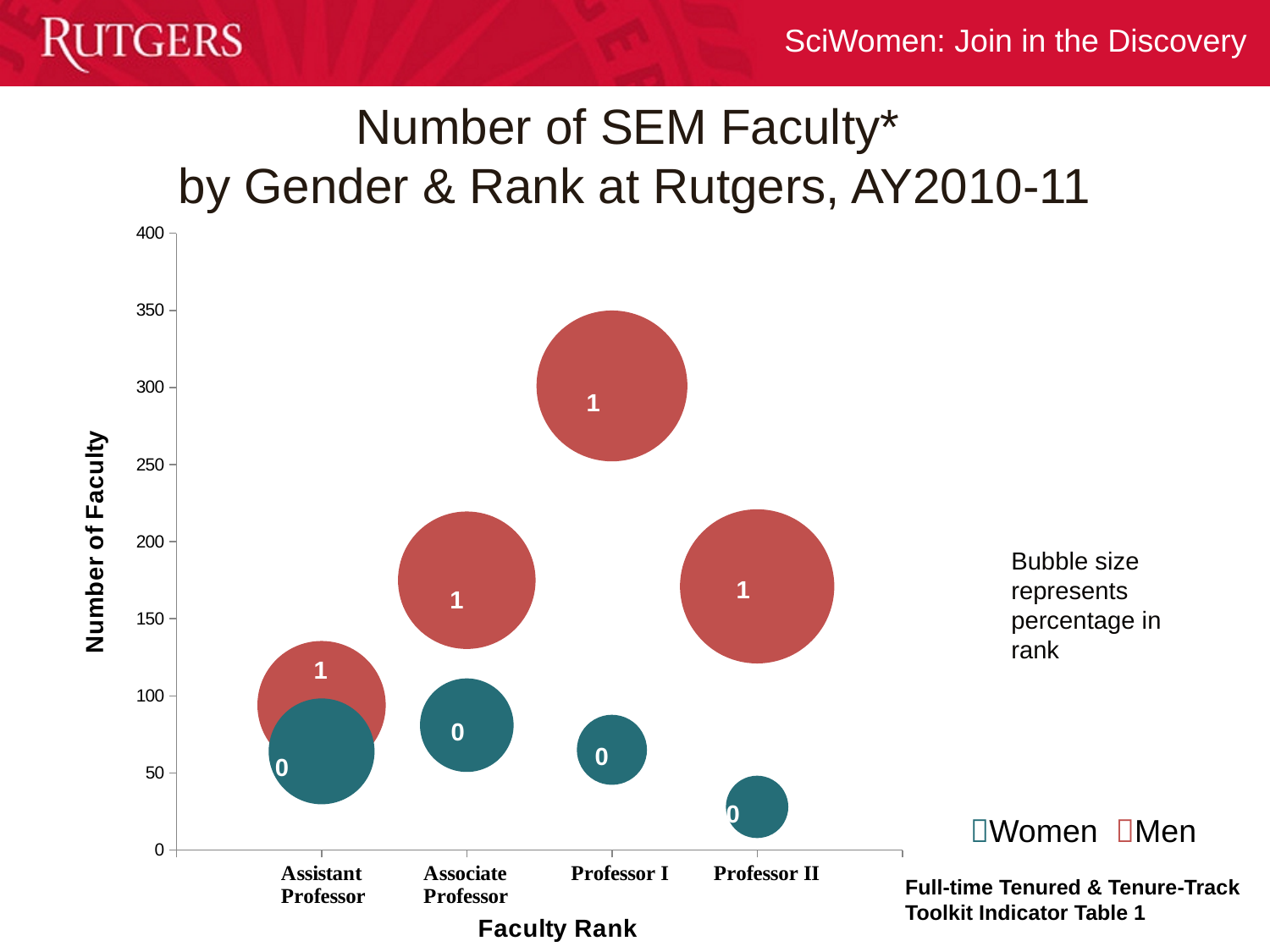
Is the Men value for Associate Professor greater or less than 150? greater How many faculty ranks are shown on the x axis? 4 Is the Men value for Professor I greater or less than 250? greater Is the Women value for Professor II greater or less than 50? less According to the slide, what does the bubble size represent? percentage in rank At Professor I, which is larger, the Men value or the Women value? Men For which faculty rank is the Women value lowest? Professor II Do the Men values rise or fall from Assistant Professor to Professor I? rise How many series does the legend list? 2 For which faculty rank is the Men value highest? Professor I What kind of chart is shown on the slide? bubble chart